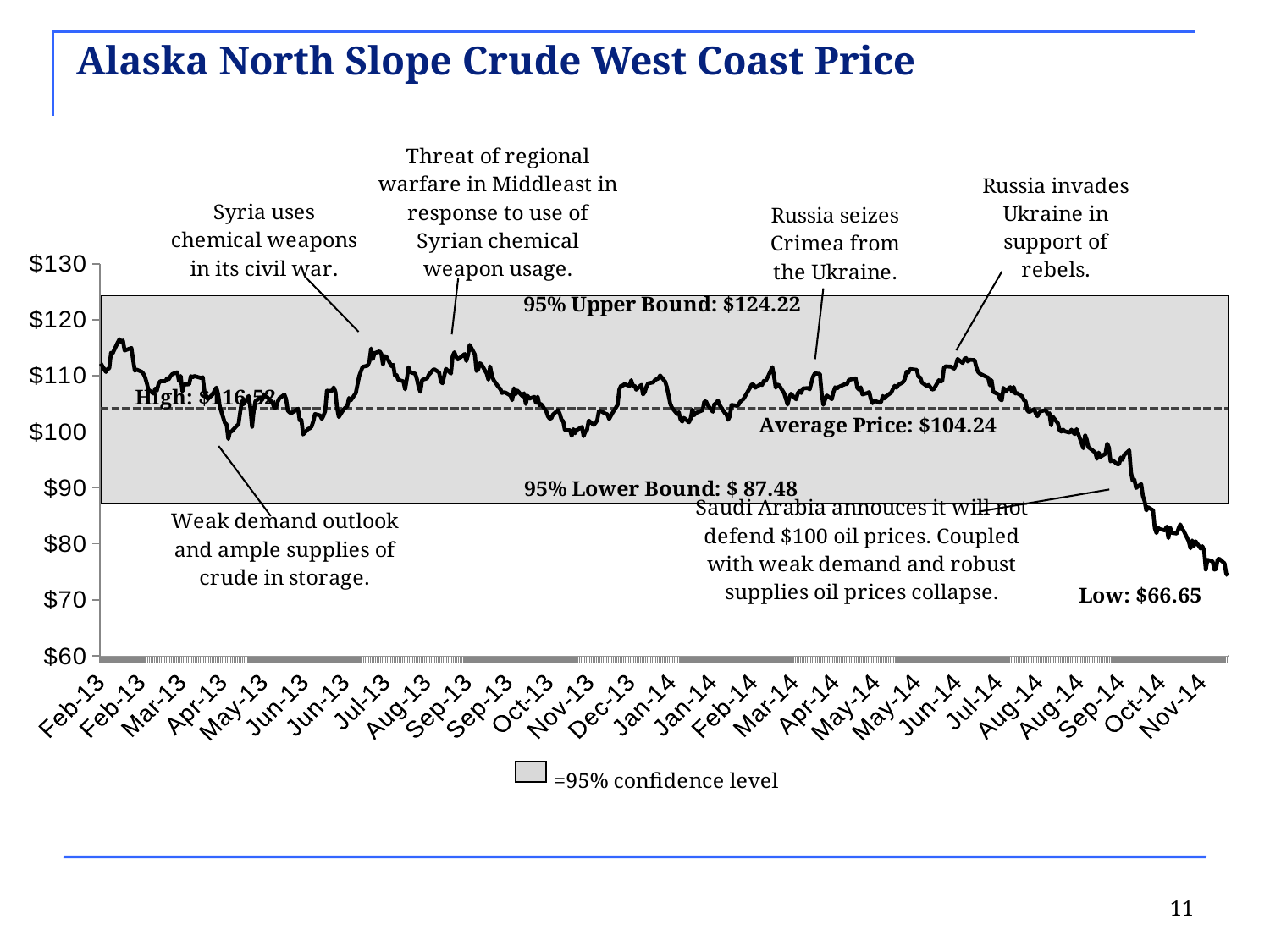
What does the shaded area on the chart represent, according to the legend? 95% confidence level What is the Low price labelled on the chart? $66.65 Overall, does the price rise or fall from Feb-13 to Nov-14? fall What is the difference between the 95% Upper Bound and the 95% Lower Bound? $36.74 What is the 95% Upper Bound price shown on the chart? $124.22 Which is larger, the Average Price or the labelled Low price? Average Price What is the Average Price shown on the chart? $104.24 What kind of chart is shown on the slide? line chart Is the price at the start of the series in Feb-13 greater or less than $100? greater What is the 95% Lower Bound price shown on the chart? $87.48 How much higher is the Average Price than the labelled Low price? $37.59 Is the price in Nov-14 greater or less than $80? less